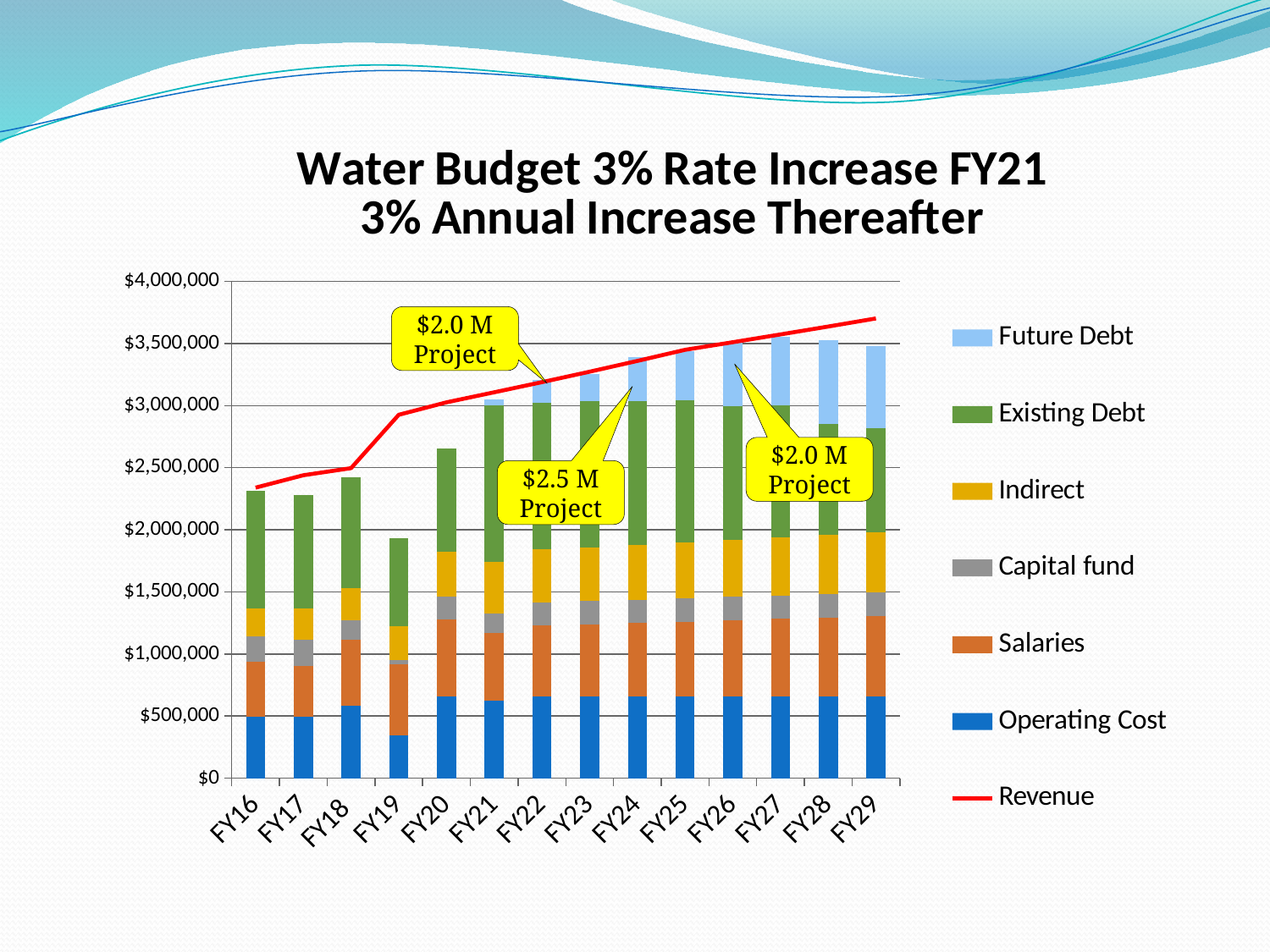
Which has the larger total stacked bar, FY19 or FY20? FY20 Is the Revenue value for FY16 greater or less than $2,500,000? less How many entries does the chart's legend list? 7 What colour is the Revenue line in the chart? red How many fiscal years are shown on the x axis of the chart? 14 Is the Revenue value for FY29 greater or less than $3,500,000? greater Which fiscal year has the lowest total stacked bar? FY19 What kind of chart is shown on the slide? combination bar and line chart (stacked bars with a line) Is the total stacked bar for FY20 greater or less than $2,500,000? greater What is the title of the chart on the slide? Water Budget 3% Rate Increase FY21 3% Annual Increase Thereafter Does the Revenue line rise or fall from FY16 to FY29? rises